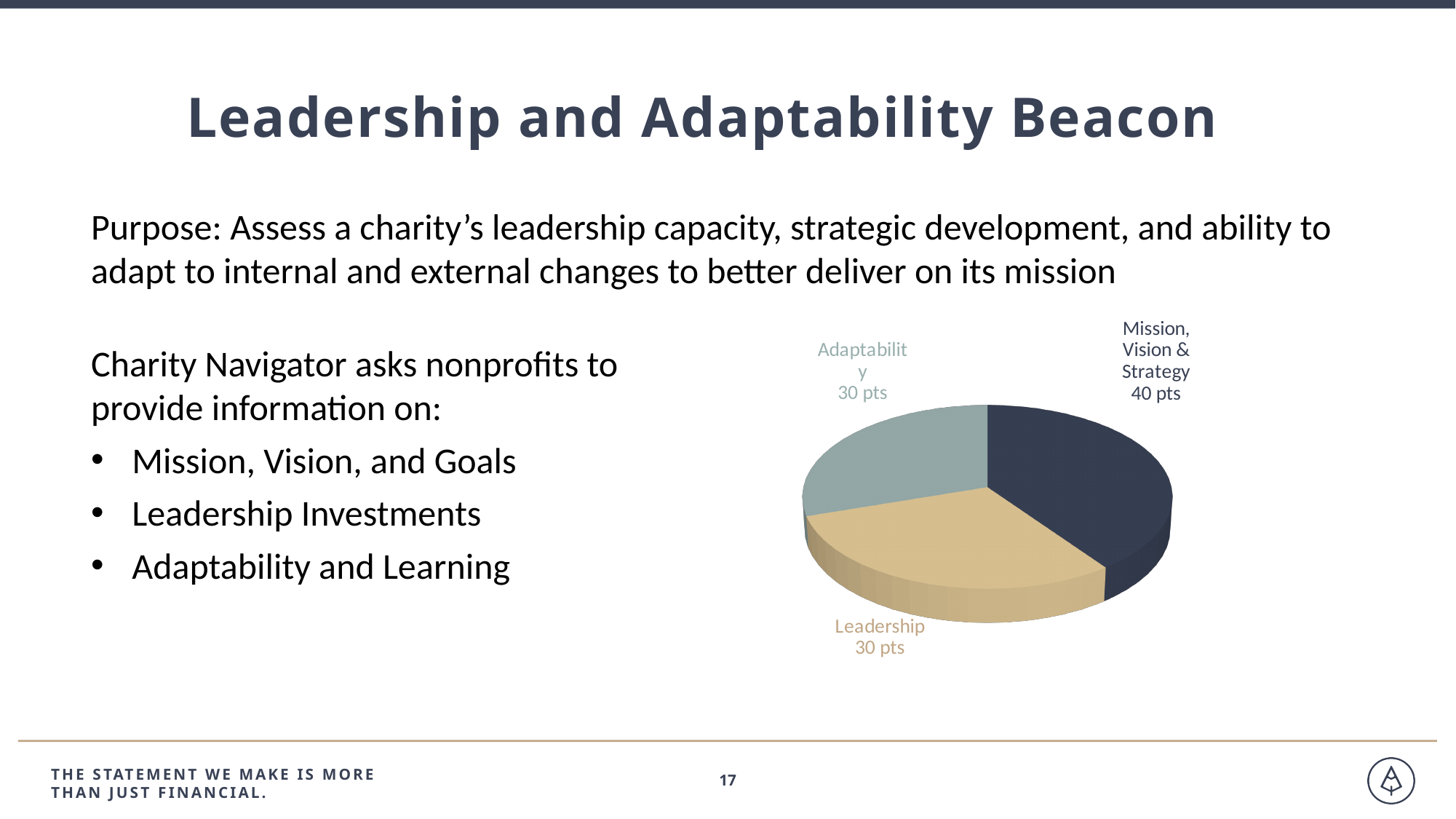
Which is larger, the Mission, Vision & Strategy slice or the Leadership slice? Mission, Vision & Strategy What kind of chart is shown on the slide? pie chart What colour is the Leadership slice of the pie chart? tan How many points is the Leadership slice worth? 30 pts How many slices does the pie chart have? 3 What is the total number of points across all slices of the pie chart? 100 pts What share of the total points does the Mission, Vision & Strategy slice represent? 40% How many points is the Adaptability slice worth? 30 pts What is the difference in points between the Mission, Vision & Strategy slice and the Adaptability slice? 10 pts Which slice of the pie chart is the largest? Mission, Vision & Strategy How many points is the Mission, Vision & Strategy slice worth? 40 pts What share of the total points does the Leadership slice represent? 30%